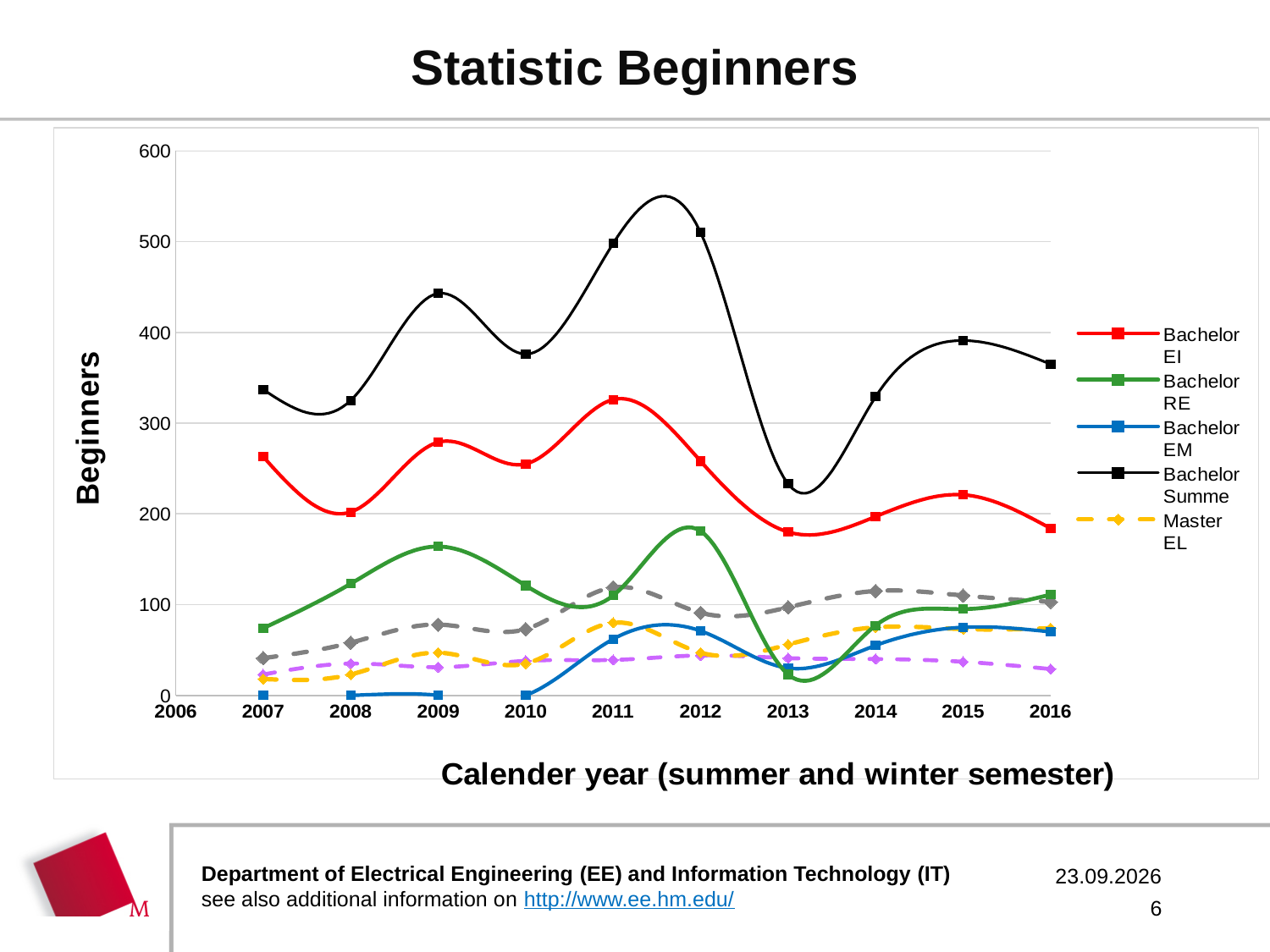
Does the Bachelor Summe line rise or fall from 2012 to 2013? fall Is the value for Bachelor RE in 2012 greater or less than 100? greater In which year does Bachelor Summe reach its lowest value? 2013 How many series does the legend list? 5 Which series is plotted with the black line? Bachelor Summe What kind of chart is shown on the slide? line chart Is the value for Bachelor Summe in 2013 greater or less than 300? less Is the value for Bachelor EI in 2011 greater or less than 300? greater What is the title of the vertical axis? Beginners Which is larger for Bachelor Summe: the value in 2009 or the value in 2010? 2009 In which year does Bachelor EI reach its highest value? 2011